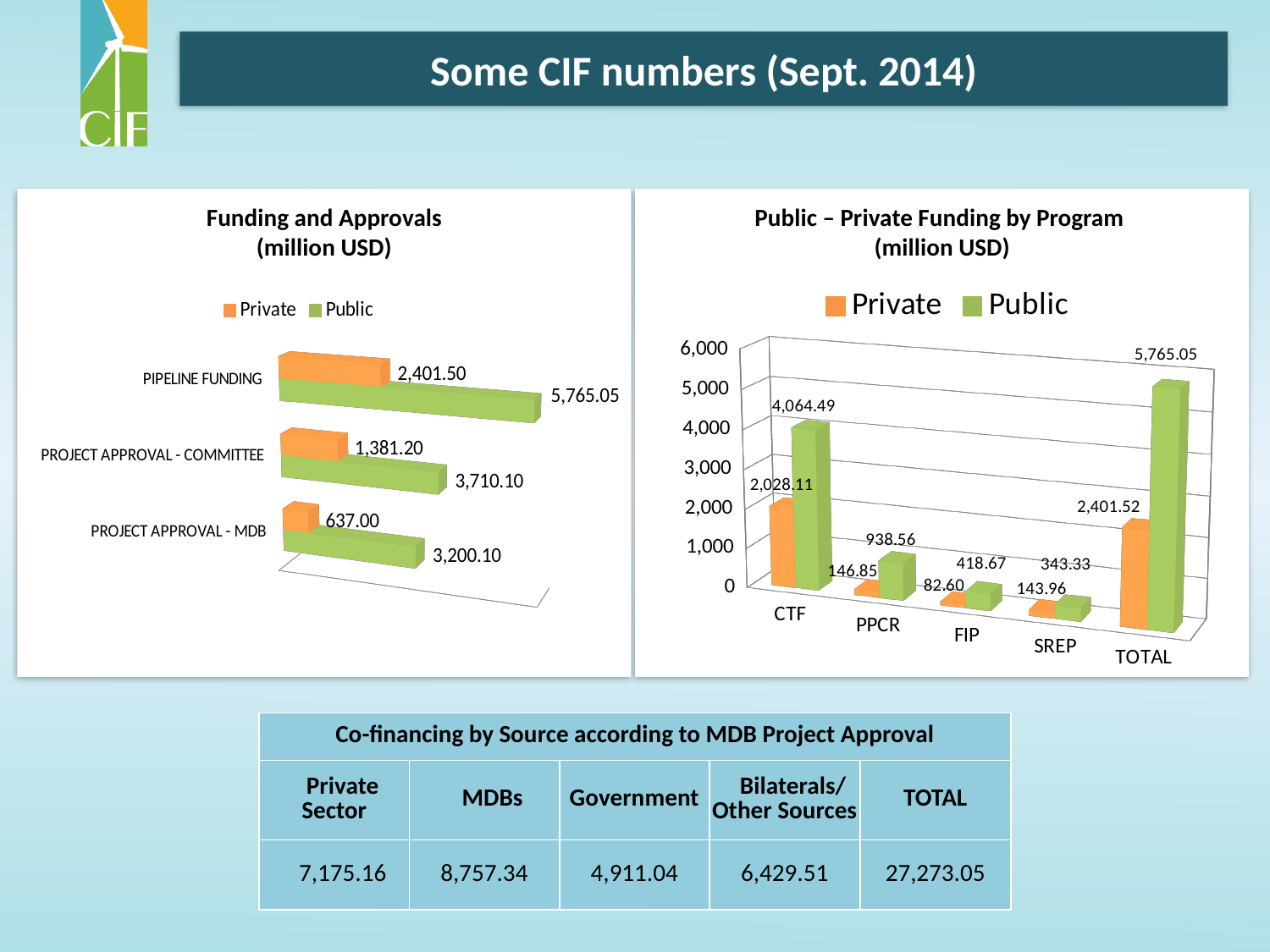
In the 'Public – Private Funding by Program' chart, is the Private value for PPCR or SREP larger? PPCR In the 'Public – Private Funding by Program' chart, what is the Public value for CTF? 4,064.49 In the 'Funding and Approvals' chart, how many categories are shown? 3 In the 'Funding and Approvals' chart, what is the difference between the Public and Private values for PROJECT APPROVAL - COMMITTEE? 2,328.90 In the 'Public – Private Funding by Program' chart, what is the difference between the Public and Private values for PPCR? 791.71 In the 'Public – Private Funding by Program' chart, which program (excluding TOTAL) has the highest Private value? CTF What type of chart is the 'Funding and Approvals' chart? Bar chart In the 'Funding and Approvals' chart, what is the Public value for PIPELINE FUNDING? 5,765.05 In the 'Funding and Approvals' chart, what is the Private value for PROJECT APPROVAL - MDB? 637.00 In the 'Public – Private Funding by Program' chart, what is the Private value for FIP? 82.60 How many series does the legend of the 'Public – Private Funding by Program' chart list? 2 In the 'Public – Private Funding by Program' chart, which program (excluding TOTAL) has the lowest Public value? SREP